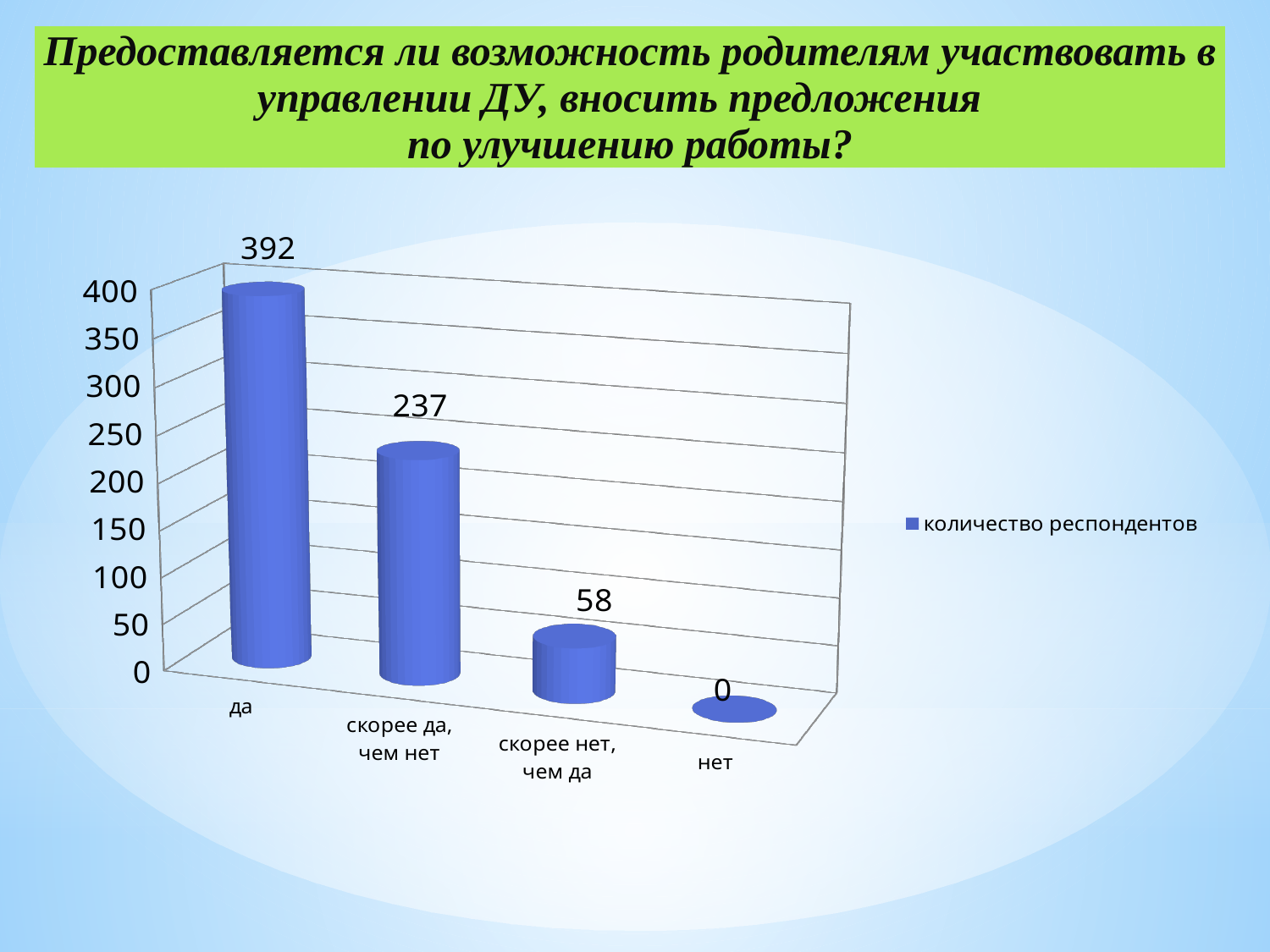
How many categories are shown on the x axis? 4 Which category has the highest value? да What is the value for "да"? 392 What is the difference between the values for "да" and "скорее да, чем нет"? 155 Which is larger: the value for "скорее да, чем нет" or the value for "скорее нет, чем да"? скорее да, чем нет What is the name of the series in the legend? количество респондентов How many series does the legend list? 1 What is the value for "скорее да, чем нет"? 237 Which category has the lowest value? нет What kind of chart is shown? bar chart What is the value for "нет"? 0 What is the value for "скорее нет, чем да"? 58